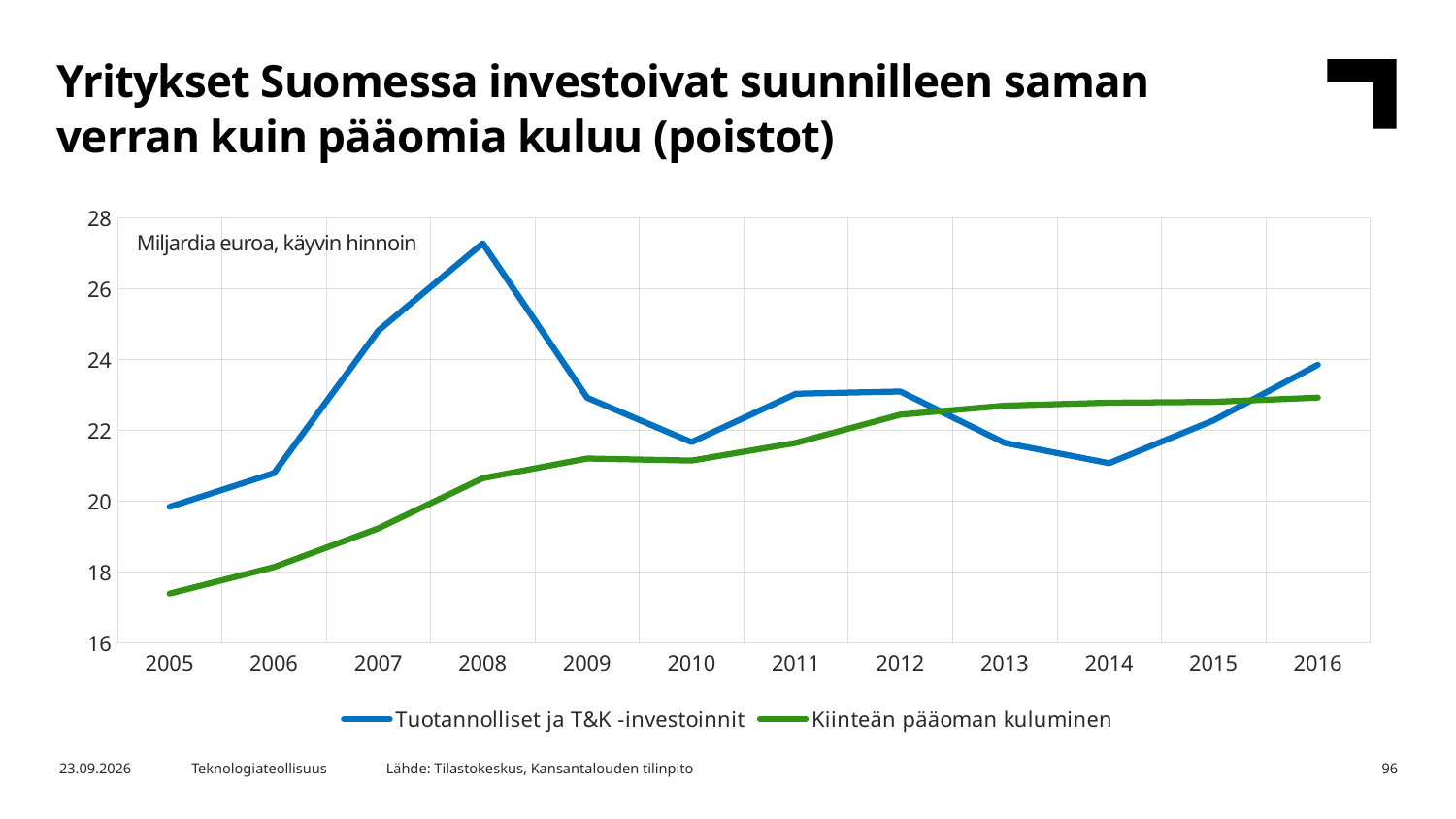
What kind of chart is shown on the slide? Line chart Does the Kiinteän pääoman kuluminen line generally rise or fall from 2005 to 2016? Rise How many years are shown on the x axis? 12 Is the value for Kiinteän pääoman kuluminen in 2005 greater or less than 18? less In which year is the Kiinteän pääoman kuluminen line at its lowest value? 2005 In which year is the Tuotannolliset ja T&K -investoinnit line at its lowest value? 2005 Is the value for Tuotannolliset ja T&K -investoinnit in 2008 greater or less than 26? greater Is the value for Tuotannolliset ja T&K -investoinnit in 2014 greater or less than 22? less In 2014, which series has the larger value: Tuotannolliset ja T&K -investoinnit or Kiinteän pääoman kuluminen? Kiinteän pääoman kuluminen How many series does the legend list? 2 In 2008, which series has the larger value: Tuotannolliset ja T&K -investoinnit or Kiinteän pääoman kuluminen? Tuotannolliset ja T&K -investoinnit In which year does the Tuotannolliset ja T&K -investoinnit line reach its highest value? 2008